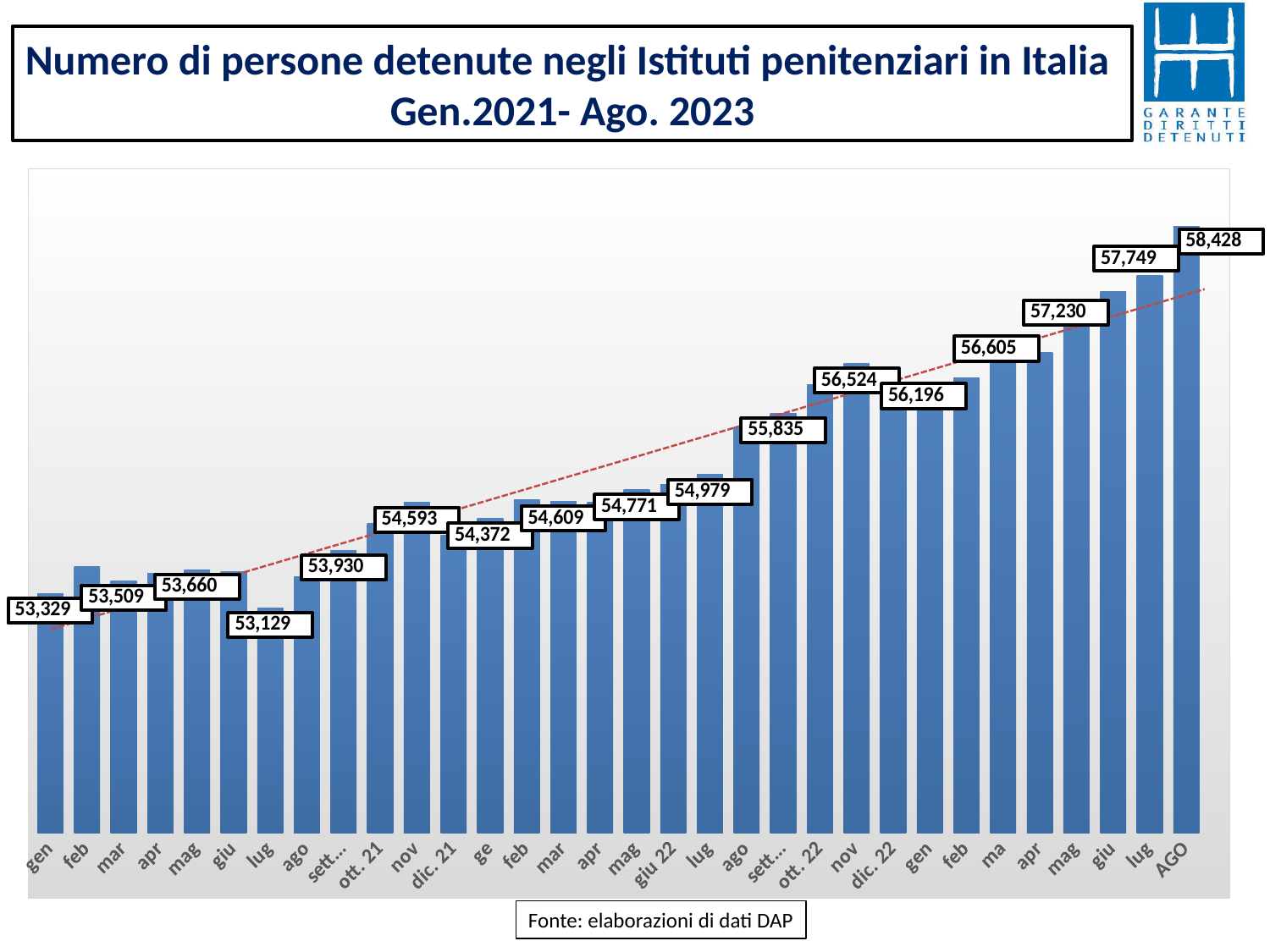
What is the difference between the two highest labelled values, 58,428 and 57,749? 679 What is the value labelled on the nov 2021 bar? 54,593 How many bars (months) are plotted on the chart? 32 Do the values generally rise or fall from January 2021 to August 2023? rise Which month has the highest number of detainees? AGO (August 2023) What kind of chart is shown on the slide? bar chart What is the lowest value labelled on the chart? 53,129 What is the value shown for the first bar, gen (January 2021)? 53,329 What is the value shown for AGO (August 2023), the last bar? 58,428 What is the title of the chart? Numero di persone detenute negli Istituti penitenziari in Italia Gen.2021- Ago. 2023 What is the difference between the last bar (AGO 2023, 58,428) and the first bar (gen 2021, 53,329)? 5,099 Which is larger, the value for AGO 2023 or the value for gen 2021? AGO 2023